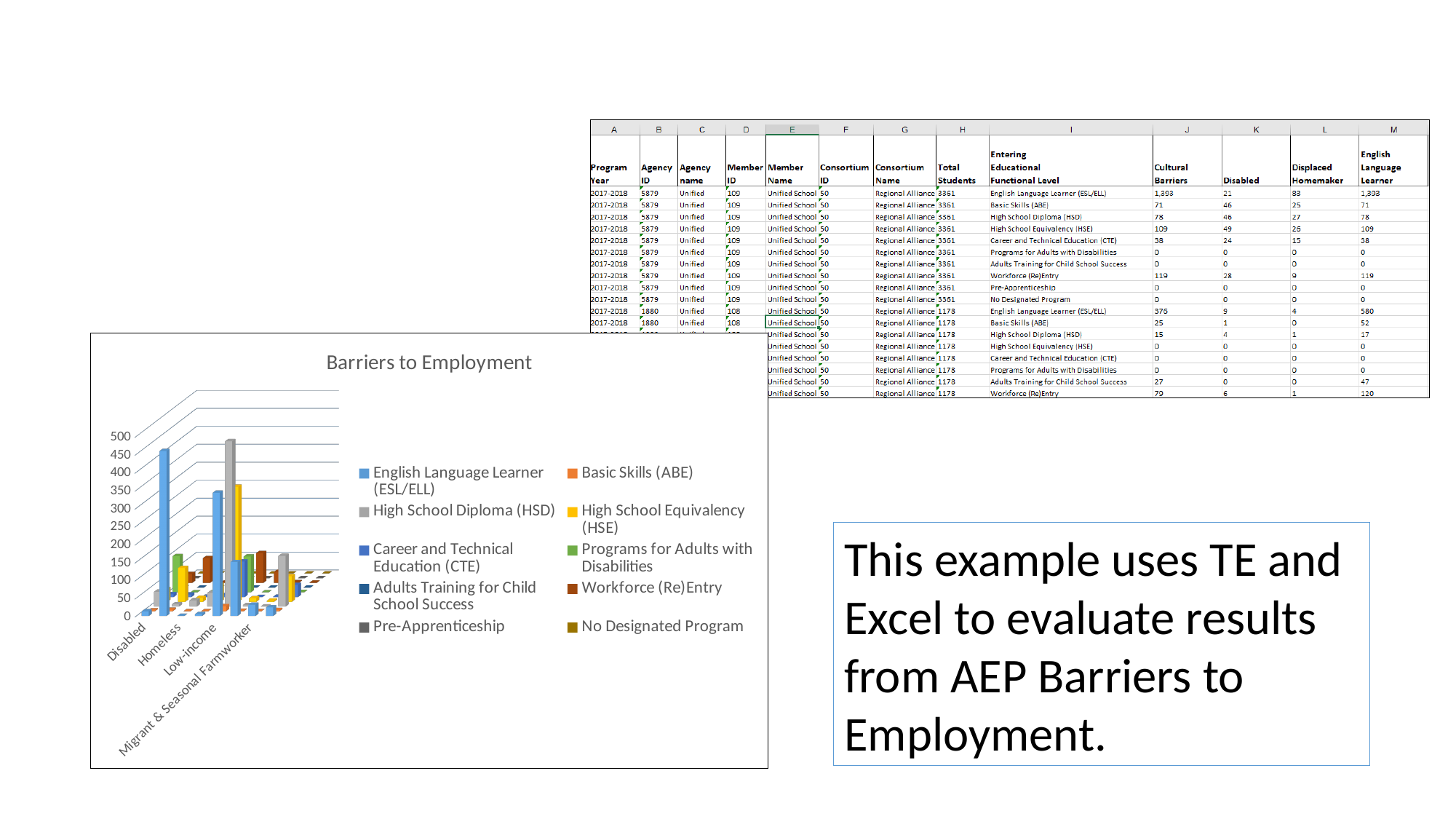
In the "Barriers to Employment" chart, is the English Language Learner (ESL/ELL) value larger for Disabled or for Low-income? Low-income How many series does the legend of the "Barriers to Employment" chart list? 10 What kind of chart is the "Barriers to Employment" chart? bar chart In the "Barriers to Employment" chart, which category has the lowest value for English Language Learner (ESL/ELL)? Homeless What is the title of the chart on the slide? Barriers to Employment In the "Barriers to Employment" chart, is the value for English Language Learner (ESL/ELL) in the Disabled category greater or less than 400? less In the "Barriers to Employment" chart, is the value for Workforce (Re)Entry in the Disabled category greater or less than 300? less What is the highest value shown on the vertical axis of the "Barriers to Employment" chart? 500 In the "Barriers to Employment" chart, is the value for English Language Learner (ESL/ELL) in the Migrant & Seasonal Farmworker category greater or less than 100? less